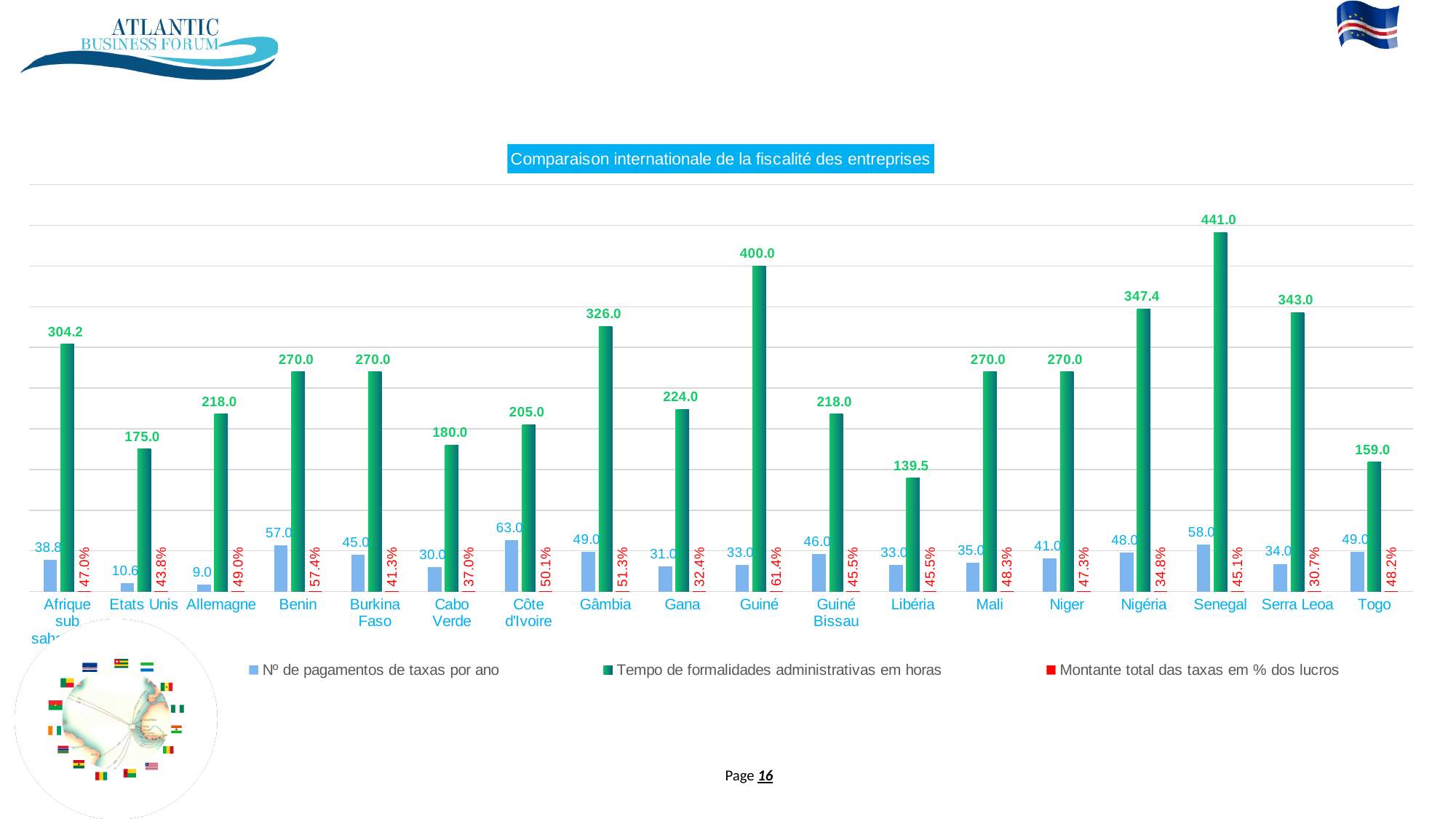
How many series does the legend list? 3 What is the difference in 'Tempo de formalidades administrativas em horas' between Senegal and Guiné? 41.0 Which category has the highest value for 'Tempo de formalidades administrativas em horas'? Senegal Which has a higher value for 'Tempo de formalidades administrativas em horas', Nigéria or Serra Leoa? Nigéria What is the value of 'Montante total das taxas em % dos lucros' for Guiné? 61.4% What kind of chart is shown on the slide? Bar chart What is the value of 'Tempo de formalidades administrativas em horas' for Senegal? 441.0 Which category has the lowest value for 'Nº de pagamentos de taxas por ano'? Allemagne What is the title of the chart? Comparaison internationale de la fiscalité des entreprises Which category has the lowest value for 'Tempo de formalidades administrativas em horas'? Libéria What is the value of 'Nº de pagamentos de taxas por ano' for Côte d'Ivoire? 63.0 Which category has the lowest value for 'Montante total das taxas em % dos lucros'? Serra Leoa